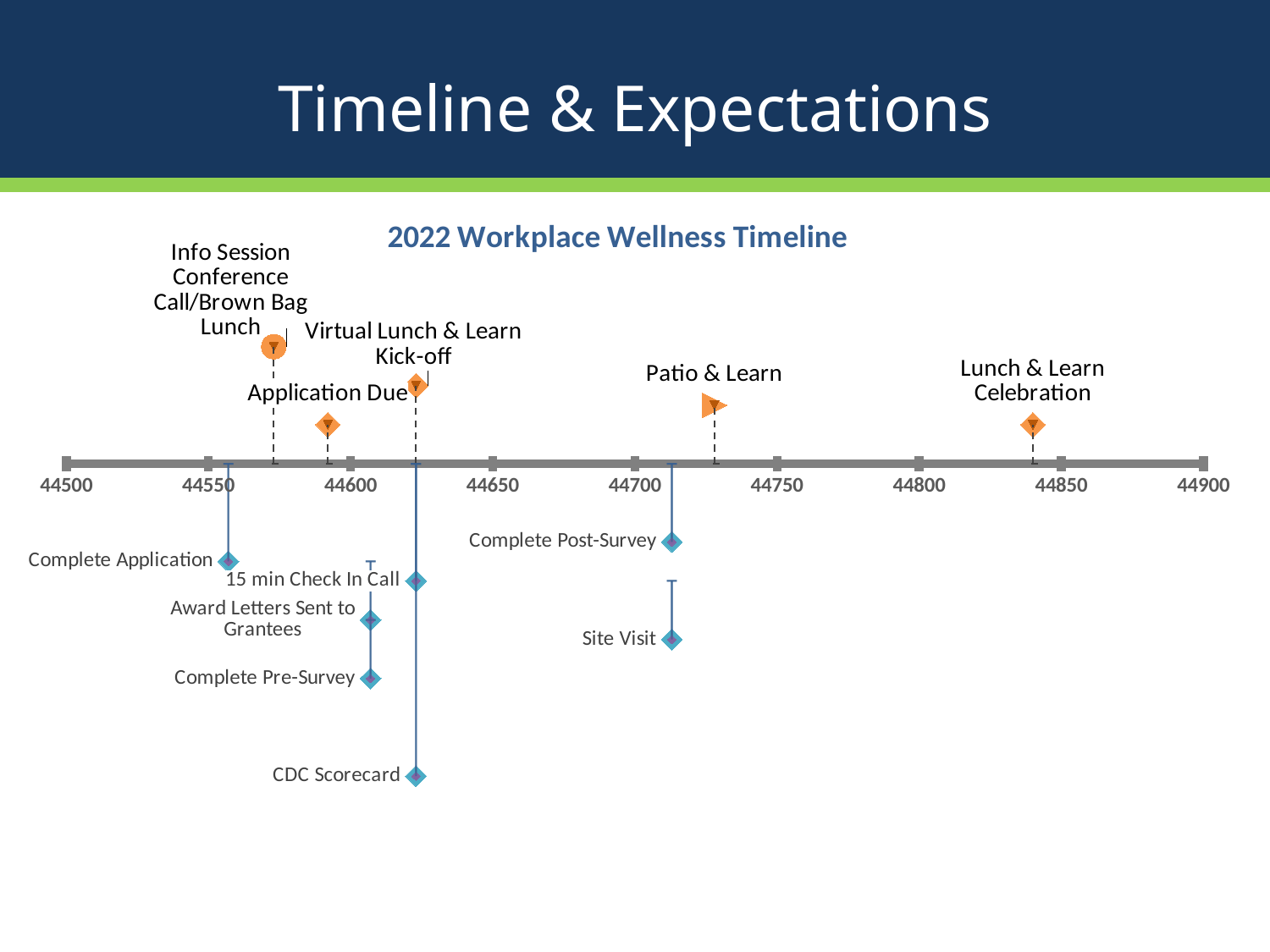
Which event is positioned earliest (furthest left) on the timeline? Complete Application What kind of chart is shown on the slide? Timeline chart What are the lowest and highest values labelled on the horizontal axis of the timeline? 44500 and 44900 What is the title of the chart on the slide? 2022 Workplace Wellness Timeline Is the value for Info Session Conference Call/Brown Bag Lunch greater or less than 44600? less How many events are marked below the axis line with blue diamond markers? 7 Is the value for Lunch & Learn Celebration greater or less than 44800? greater Which event is positioned latest (furthest right) on the timeline? Lunch & Learn Celebration Which occurs later on the timeline, Application Due or Patio & Learn? Patio & Learn How many events are marked above the axis line with orange markers? 5 Is the value for Complete Application greater or less than 44600? less